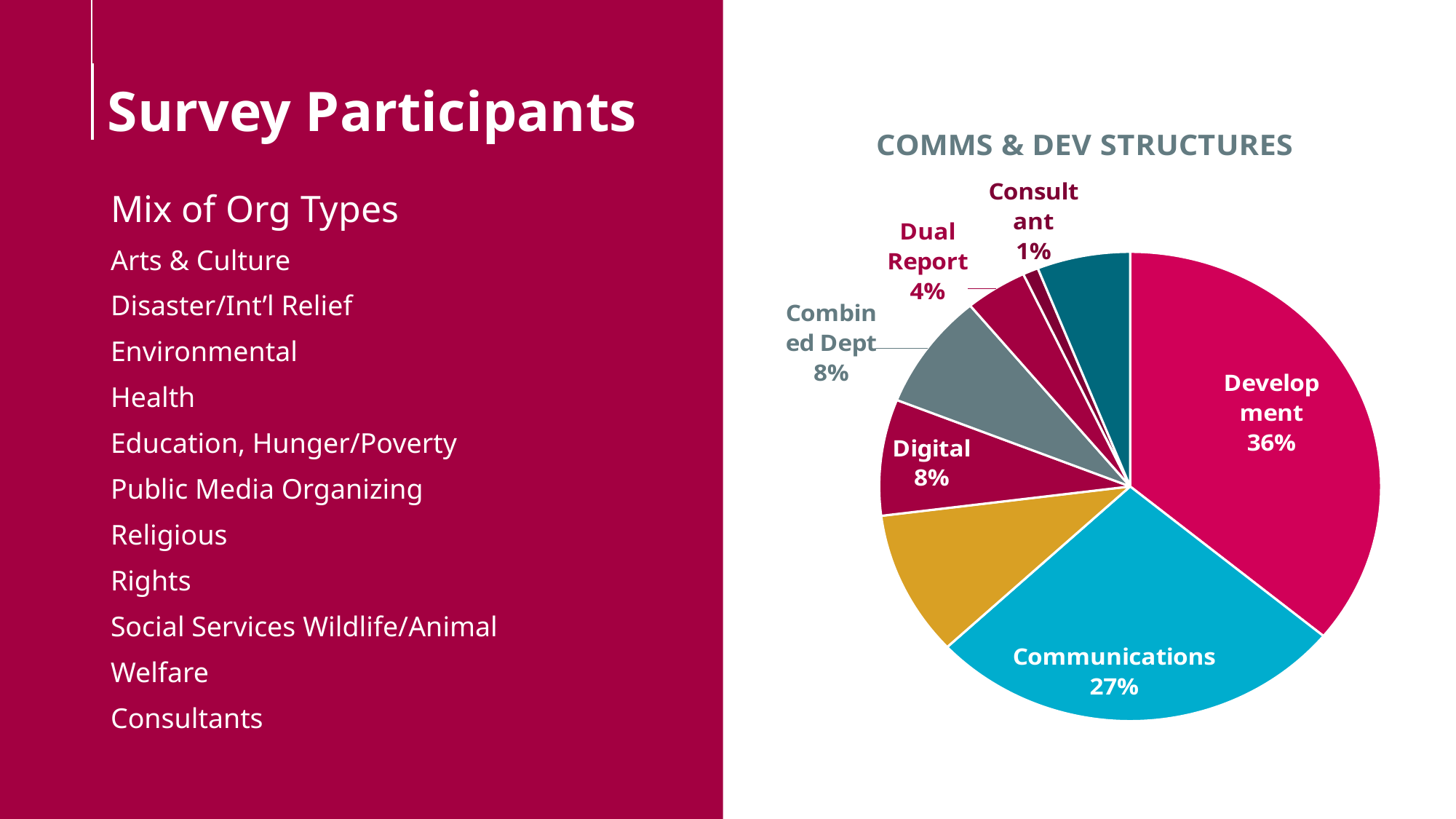
What kind of chart is shown on the slide? pie chart What is the difference in percentage points between Development and Communications? 9 What is the title of the chart? COMMS & DEV STRUCTURES Which labeled slice has the largest share? Development What is the value shown for Consultant? 1% What is the value shown for Combined Dept? 8% What is the value shown for Digital? 8% Which labeled slice has the smallest share? Consultant Which is larger, Communications or Digital? Communications What is the value shown for Communications? 27% What is the value shown for Dual Report? 4% What share of the pie does Development hold? 36%